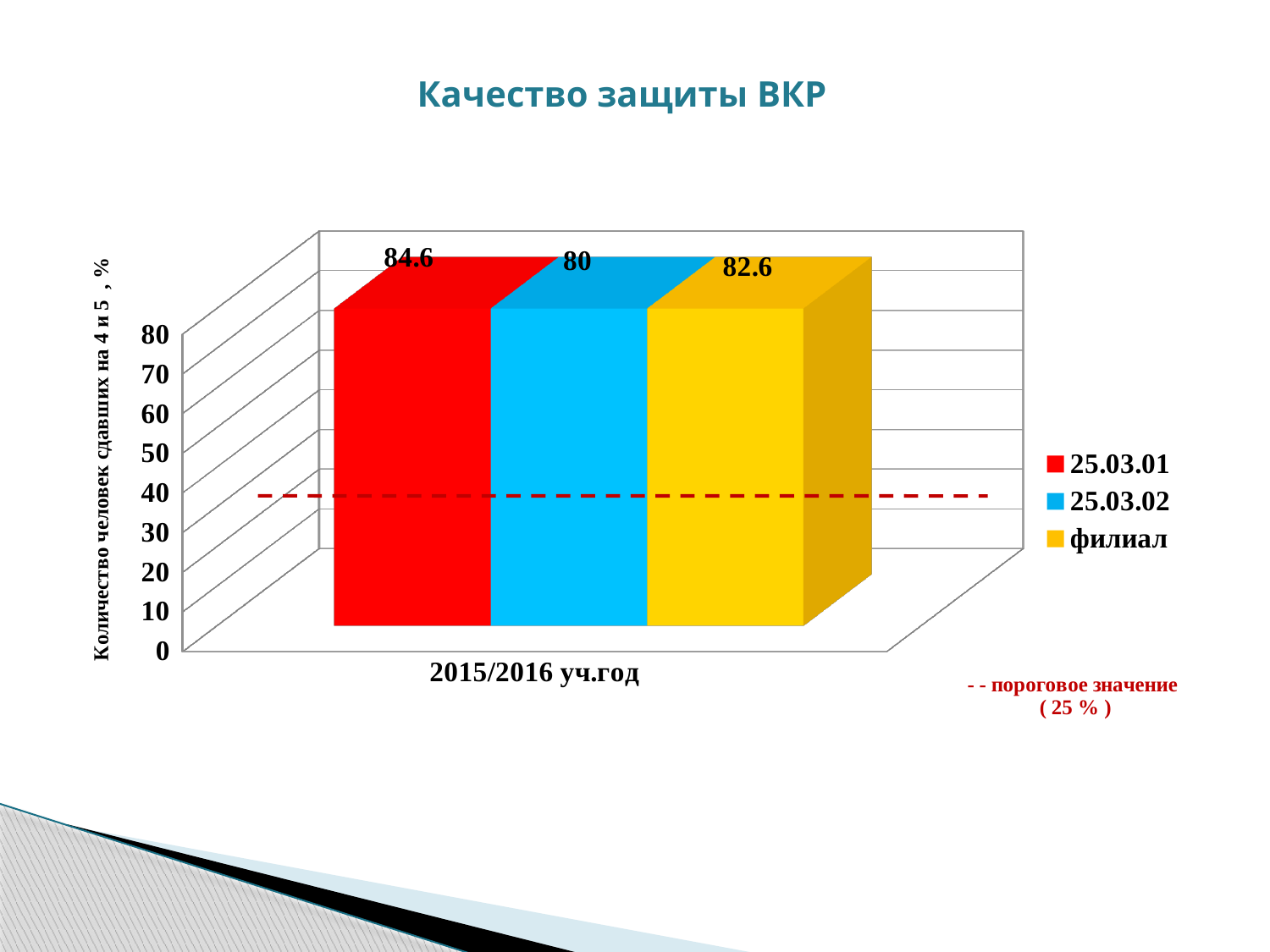
What is the difference between the values for 25.03.01 and 25.03.02? 4.6 Which series has the highest value? 25.03.01 What is the title of the chart? Качество защиты ВКР How many series does the legend list? 3 What is the value for series 25.03.02 in 2015/2016 уч.год? 80 Which is larger, the value for 25.03.01 or the value for филиал? 25.03.01 What is the difference between the values for филиал and 25.03.02? 2.6 What is the value for series 25.03.01 in 2015/2016 уч.год? 84.6 Which series has the lowest value? 25.03.02 What threshold value does the dashed red line represent, according to the note on the slide? 25 % What kind of chart is shown on the slide? bar chart What is the value for series филиал in 2015/2016 уч.год? 82.6